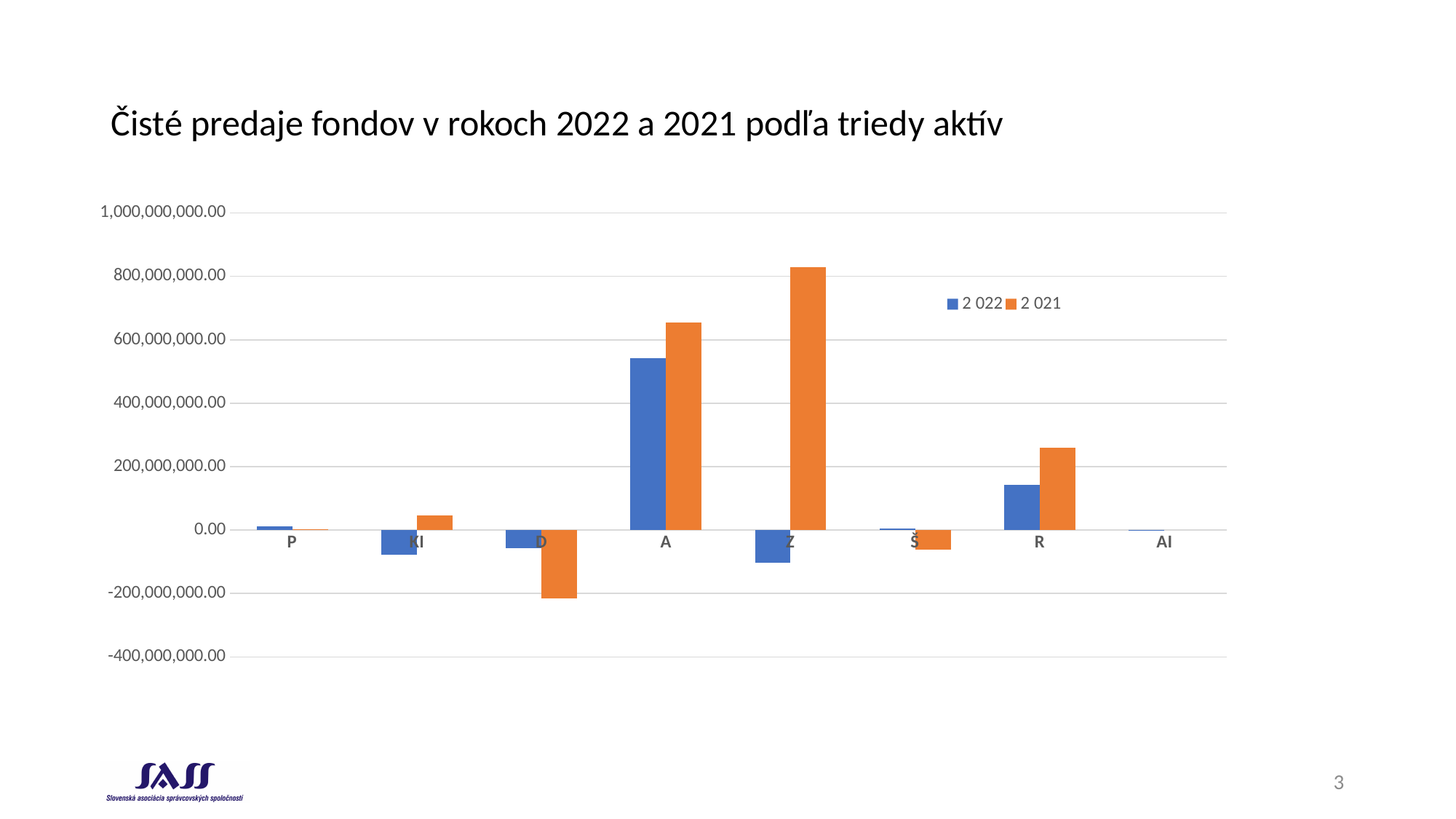
Is the 2 021 value for R greater or less than 200,000,000.00? greater How many asset-class categories are shown on the x axis? 8 Is the 2 021 value for A greater or less than 600,000,000.00? greater Which category has the lowest value for the 2 022 series? Z How many series does the legend list? 2 What kind of chart is shown on the slide? bar chart What is the title of the chart? Čisté predaje fondov v rokoch 2022 a 2021 podľa triedy aktív Which category has the highest value for the 2 021 series? Z Which category has the highest value for the 2 022 series? A For category Z, which series has the larger value, 2 022 or 2 021? 2 021 Which category has the lowest value for the 2 021 series? D Is the 2 022 value for A greater or less than 400,000,000.00? greater